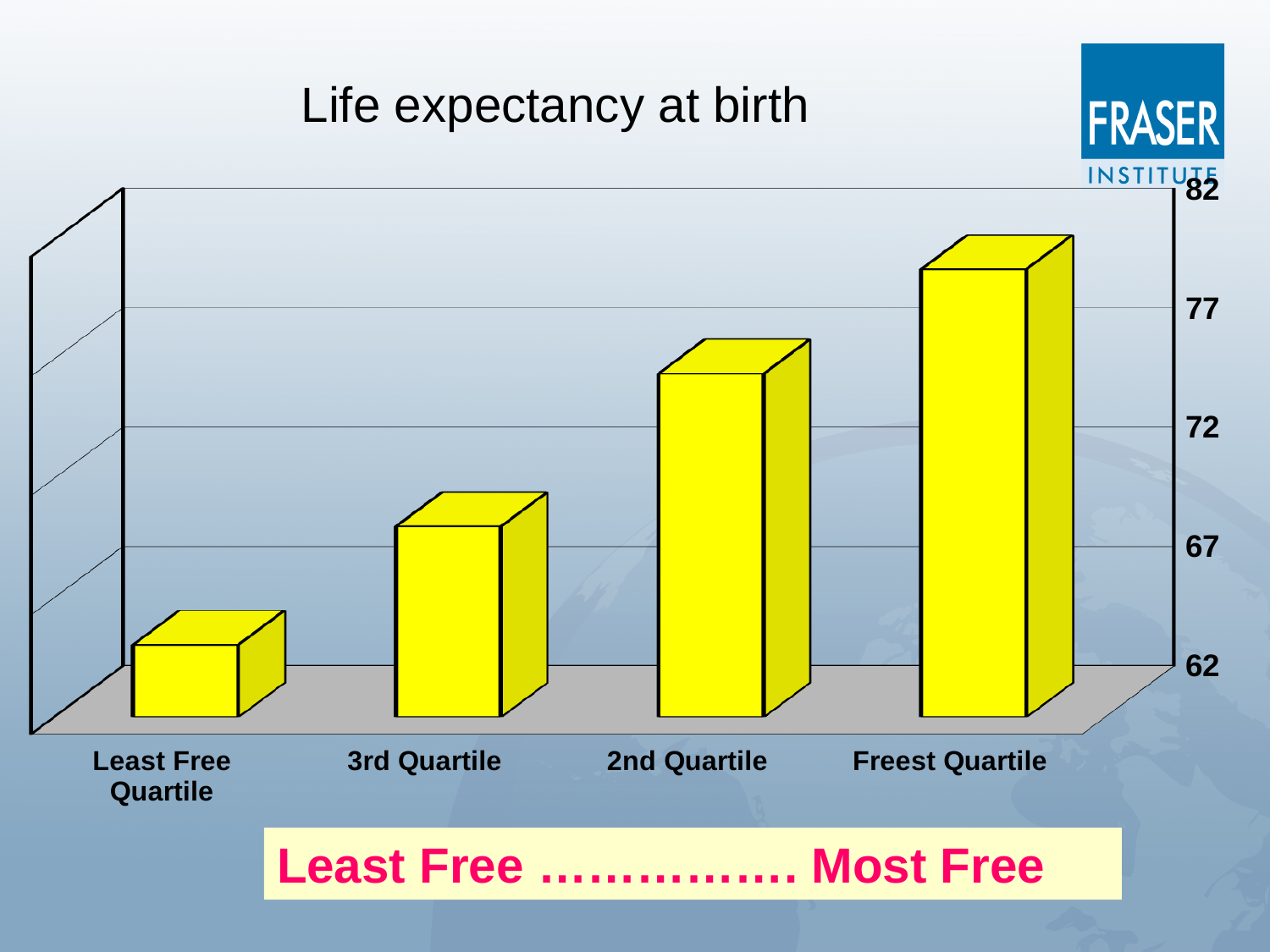
How many categories are plotted in the chart? 4 Which is larger, the value for the 2nd Quartile or the value for the 3rd Quartile? 2nd Quartile What is the title of the chart? Life expectancy at birth What kind of chart is shown on the slide? bar chart Is the value for the Least Free Quartile greater or less than 67? less Is the value for the 3rd Quartile greater or less than 67? greater Is the value for the 2nd Quartile greater or less than 72? greater Which category has the lowest life expectancy at birth? Least Free Quartile Which category has the highest life expectancy at birth? Freest Quartile Do the values rise or fall moving from the Least Free Quartile to the Freest Quartile? rise